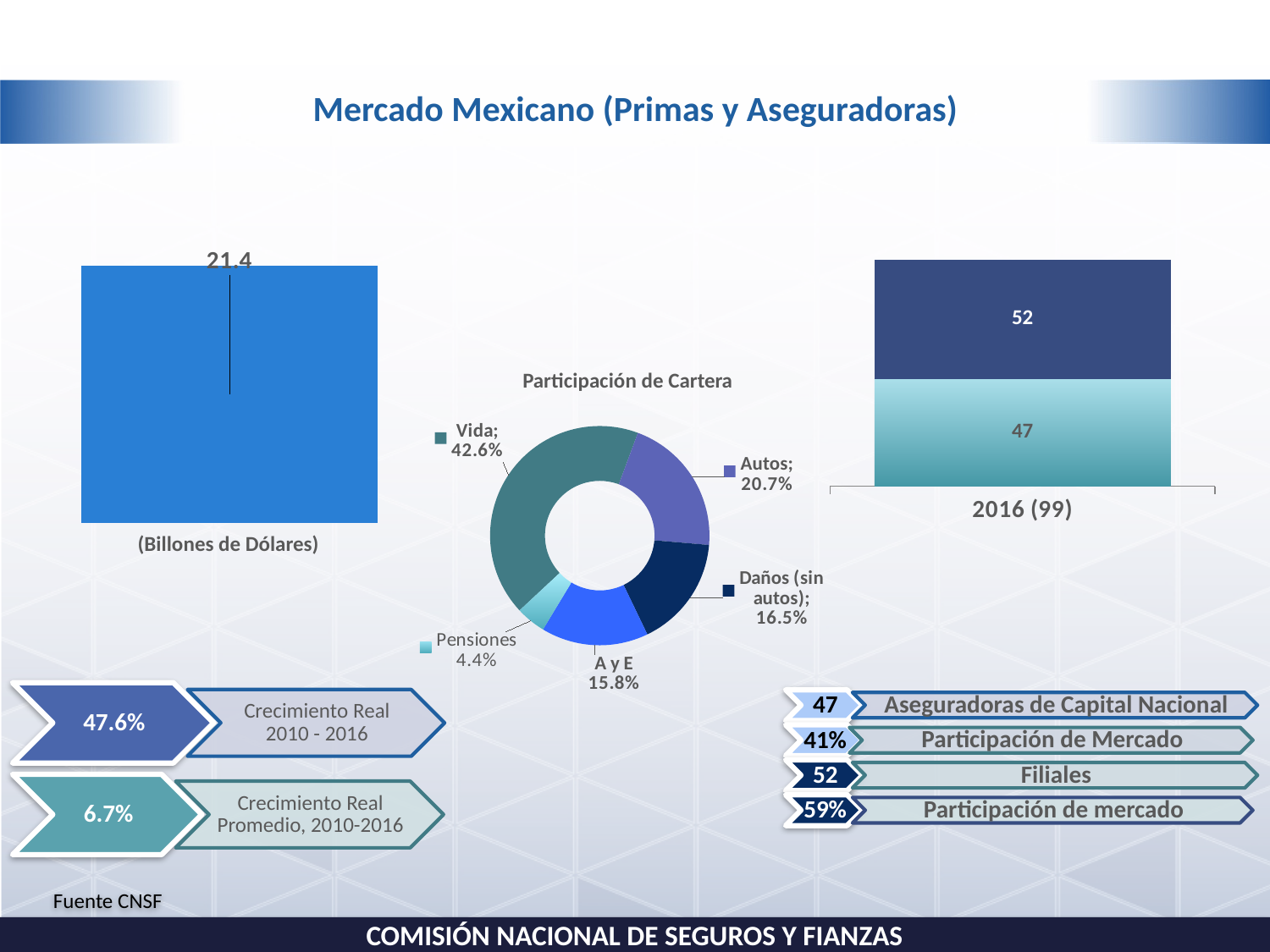
In the "Participación de Cartera" chart, what is the share for Vida? 42.6% In the "Participación de Cartera" chart, which is larger, Autos or Daños (sin autos)? Autos In the left bar chart labelled "(Billones de Dólares)", what value is printed on the bar? 21.4 In the stacked bar chart on the right, what is the difference between the two segments (52 and 47)? 5 In the "Participación de Cartera" chart, what is the difference in percentage points between Vida and Autos? 21.9 In the "Participación de Cartera" chart, which category has the largest share? Vida In the "Participación de Cartera" chart, what is the share for Daños (sin autos)? 16.5% In the stacked bar chart on the right, what is the total of the stacked bar for 2016 (99)? 99 What kind of chart is the left chart labelled "(Billones de Dólares)"? bar chart In the stacked bar chart on the right, what is the value of the top (dark blue) segment for 2016 (99)? 52 In the "Participación de Cartera" chart, which category has the smallest share? Pensiones In the "Participación de Cartera" chart, how many categories are shown? 5